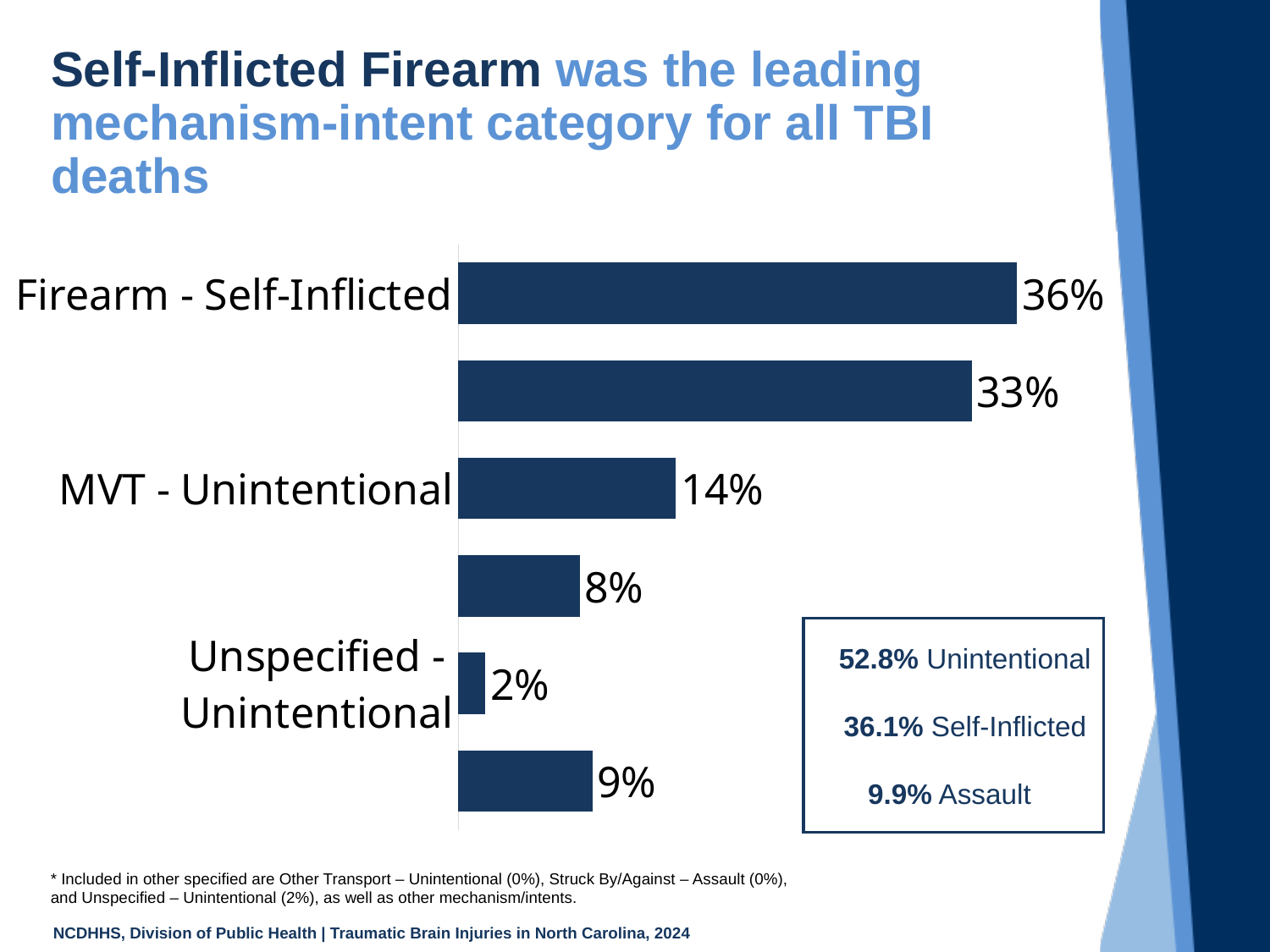
What is the difference between the values for MVT - Unintentional and Unspecified - Unintentional? 12 percentage points What is the difference between the values for Firearm - Self-Inflicted and MVT - Unintentional? 22 percentage points What kind of chart is shown on the slide? Bar chart What is the value for Unspecified - Unintentional? 2% What is the value for Firearm - Self-Inflicted? 36% Which category has the lowest value? Unspecified - Unintentional What is the value for MVT - Unintentional? 14% Which category has the highest value? Firearm - Self-Inflicted Which is larger, the value for MVT - Unintentional or the value for Unspecified - Unintentional? MVT - Unintentional According to the text box on the slide, what percentage of TBI deaths were Unintentional? 52.8% Which is larger, the value for Firearm - Self-Inflicted or the value for MVT - Unintentional? Firearm - Self-Inflicted How many bars are plotted in the chart? 6